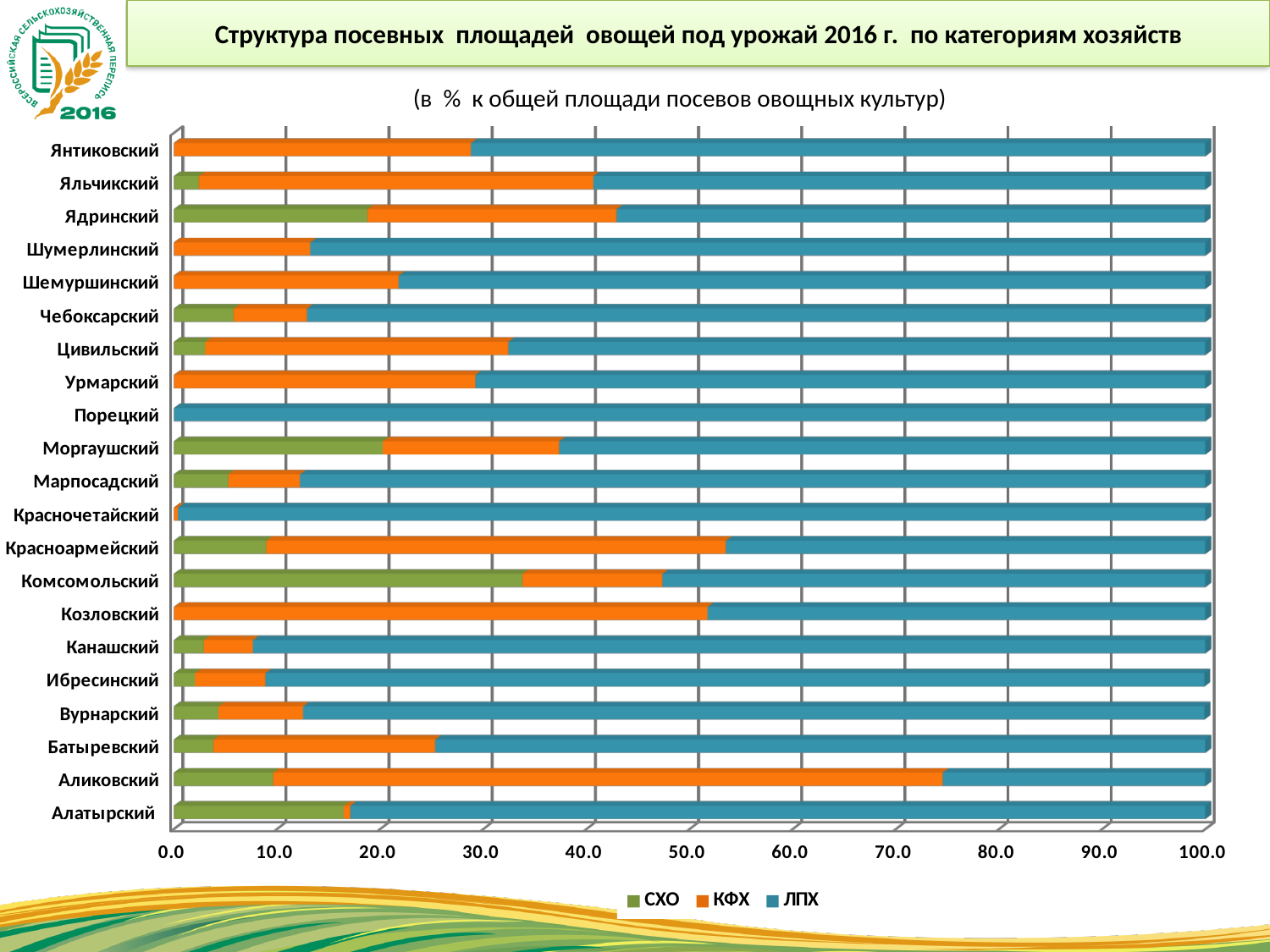
What kind of chart is shown on the slide? Stacked bar chart How many series does the legend list? 3 Which district has the largest СХО share? Комсомольский Is the ЛПХ share for Шумерлинский greater or less than 80? greater Which district has the largest КФХ share? Аликовский Is the СХО share for Комсомольский greater or less than 30? greater Which district has a larger СХО share, Моргаушский or Цивильский? Моргаушский Is the КФХ share for Аликовский greater or less than 60? greater Which district has the smallest ЛПХ share? Аликовский Which colour represents the ЛПХ series in the legend? Blue Which district has a larger КФХ share, Козловский or Канашский? Козловский How many districts (categories) are plotted on the chart? 21